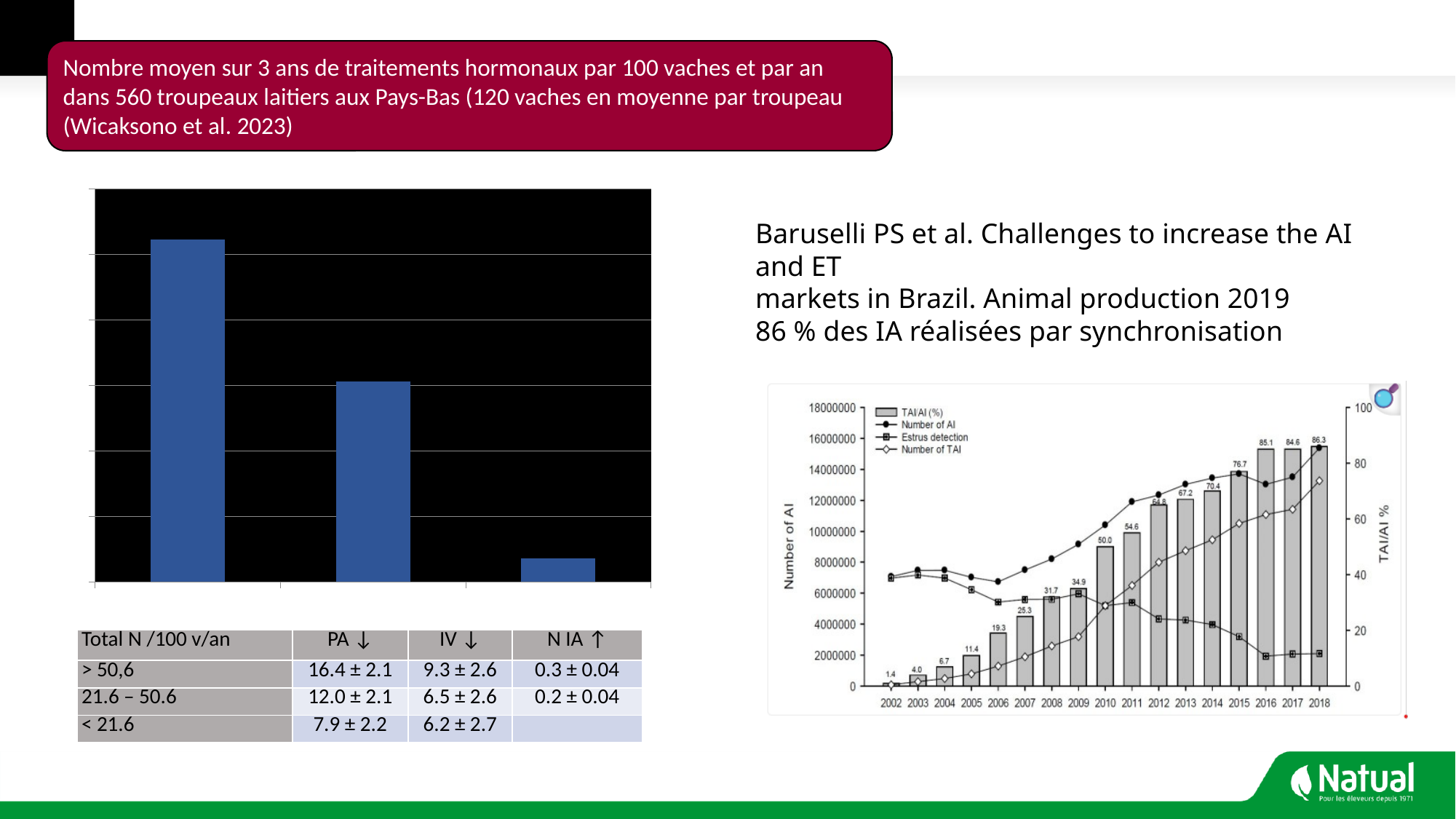
How many series does the legend of the Brazil AI chart on the right list? 4 How many bars does the chart on the left of the slide show? 3 In the Brazil AI chart on the right, which year has the lowest TAI/AI (%) value? 2002 In the Brazil AI chart on the right, which year has the highest TAI/AI (%) value? 2018 In the Brazil AI chart on the right, is the Number of AI in 2002 greater or less than 8000000? less What type of chart is the chart on the left of the slide? bar chart In the Brazil AI chart on the right, what is the difference between the TAI/AI (%) values for 2018 and 2002? 84.9 In the Brazil AI chart on the right, is the Number of TAI in 2018 greater or less than 12000000? greater In the chart on the left of the slide, do the bar values rise or fall from left to right? fall In the Brazil AI chart on the right, is the TAI/AI (%) value larger in 2016 or in 2017? 2016 In the Brazil AI chart on the right, what is the TAI/AI (%) value for 2018? 86.3 In the Brazil AI chart on the right, what is the TAI/AI (%) value for 2010? 50.0